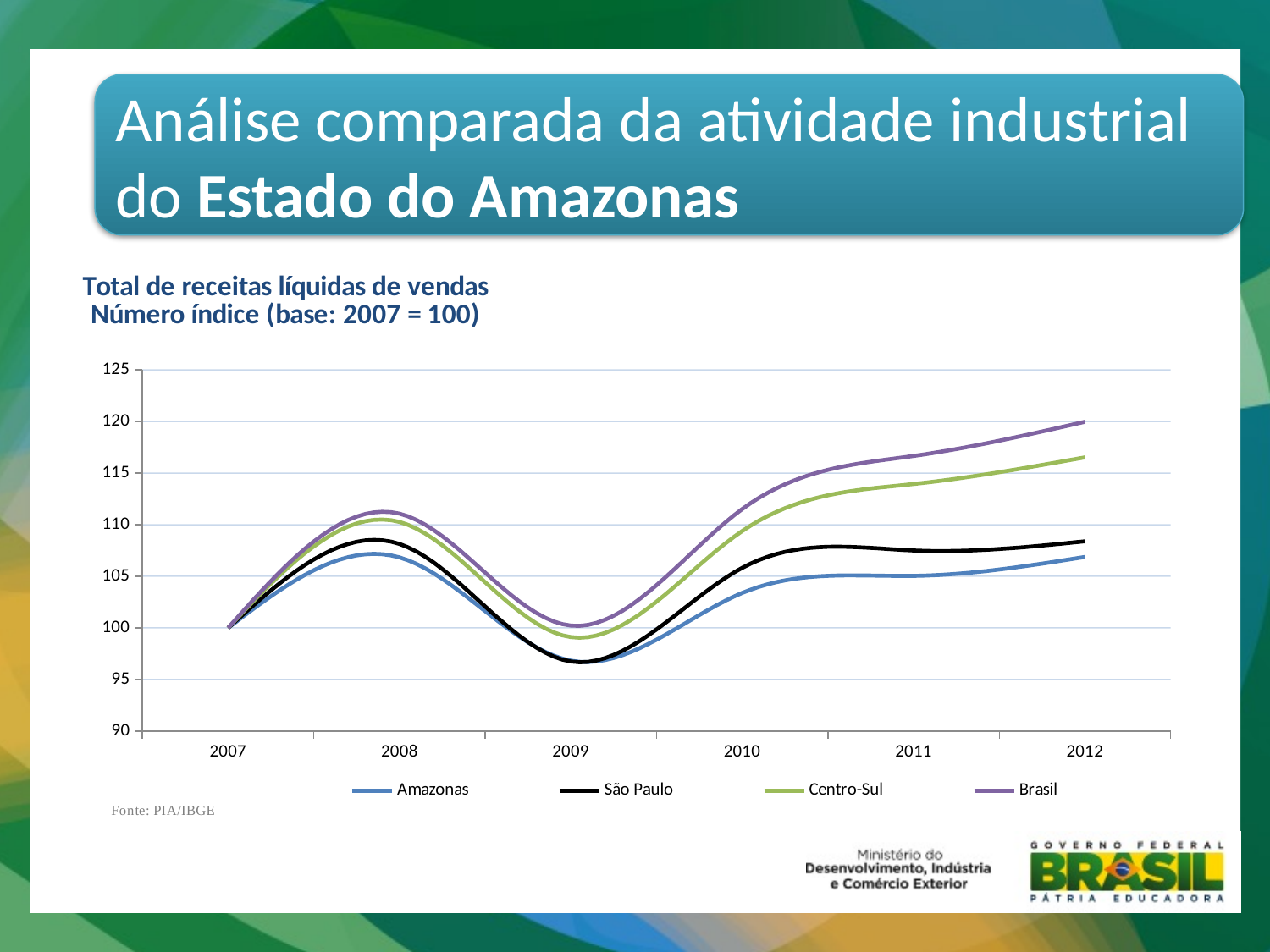
What is the index value for Amazonas in 2007? 100 Which series has the highest value in 2012? Brasil What kind of chart is shown on the slide? line chart Which is larger in 2010, the value for Brasil or the value for Amazonas? Brasil What source is cited below the chart? PIA/IBGE Is the value for Brasil in 2012 greater or less than 115? greater Which series has the lowest value in 2012? Amazonas In which year does the São Paulo series reach its lowest value? 2009 How many years are shown on the x axis? 6 How many series does the legend list? 4 Is the value for Amazonas in 2009 greater or less than 100? less Does the Brasil series rise or fall from 2009 to 2012? rise